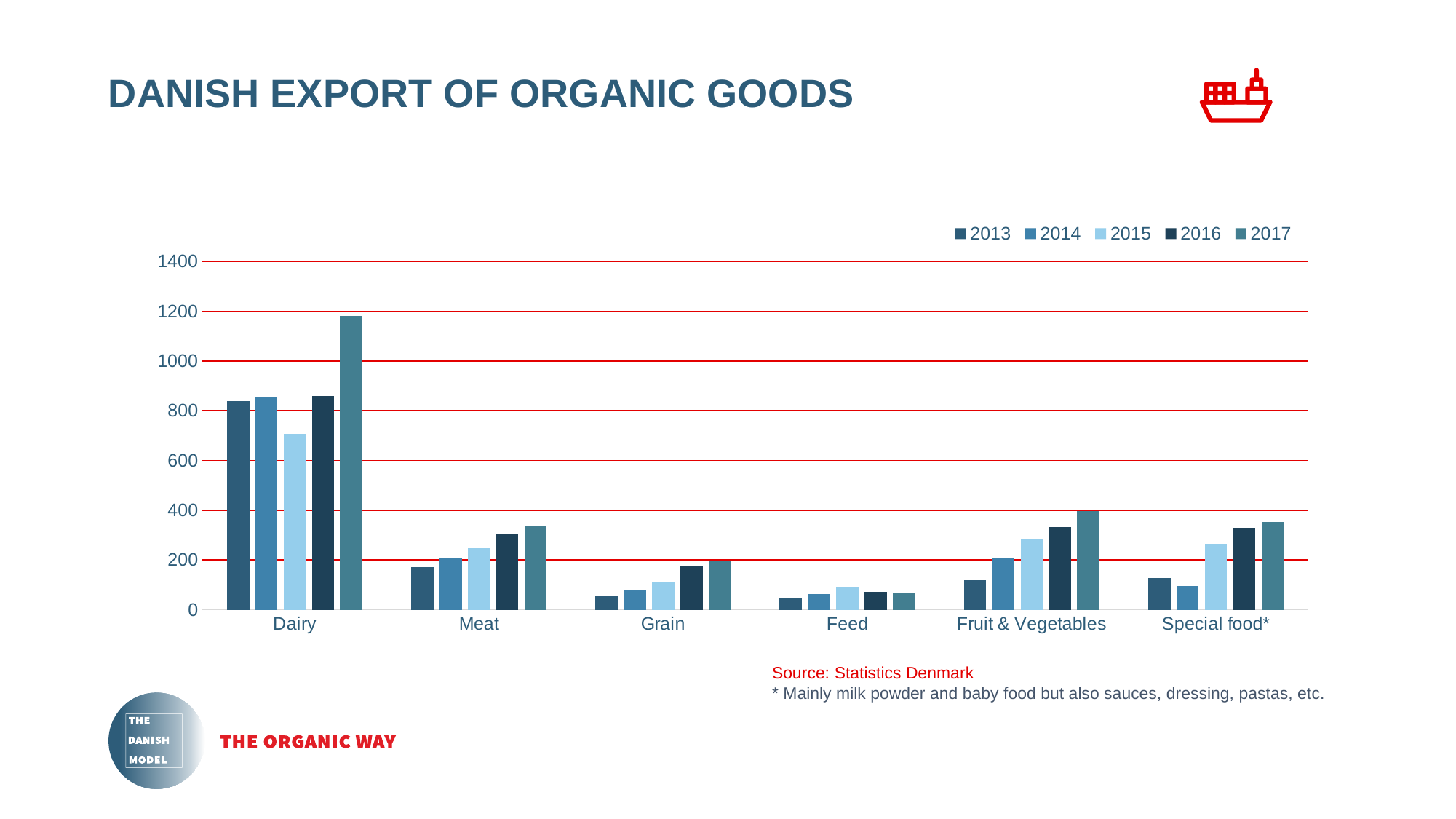
What kind of chart is shown on the slide? Bar chart Which category has the highest value for 2017? Dairy What source is cited for the chart? Statistics Denmark Do the values for Meat rise or fall from 2013 to 2017? rise How many series does the legend list? 5 Which category has the lowest value for 2017? Feed How many product categories are shown on the x axis? 6 Which is larger, the 2013 value for Dairy or the 2015 value for Dairy? 2013 Is the value for Dairy in 2017 greater or less than 1000? greater Is the value for Dairy in 2015 greater or less than 800? less Is the value for Special food* in 2014 greater or less than 200? less Which is larger, the 2017 value for Meat or the 2017 value for Grain? Meat